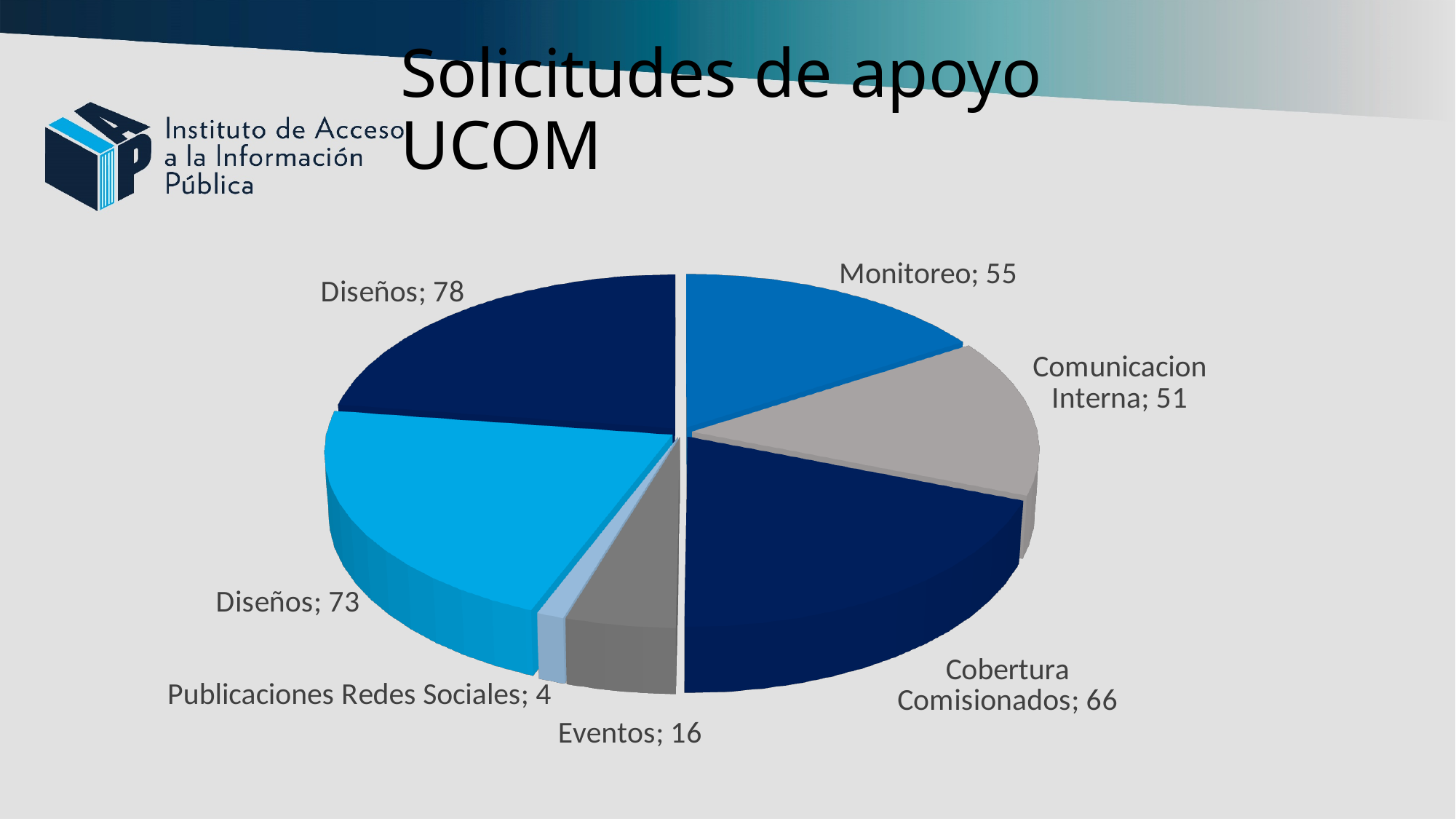
Which is larger, the value for Monitoreo or the value for Comunicacion Interna? Monitoreo What is the title of the slide containing the chart? Solicitudes de apoyo UCOM What kind of chart is shown on the slide? pie chart What is the difference between the values for Cobertura Comisionados and Monitoreo? 11 How many slices does the pie chart have? 7 What is the value for Cobertura Comisionados? 66 Which category has the largest slice of the pie? Diseños (78) What is the value for Publicaciones Redes Sociales? 4 What is the value for Eventos? 16 Which category has the smallest slice of the pie? Publicaciones Redes Sociales What is the value for Comunicacion Interna? 51 What is the value for Monitoreo? 55